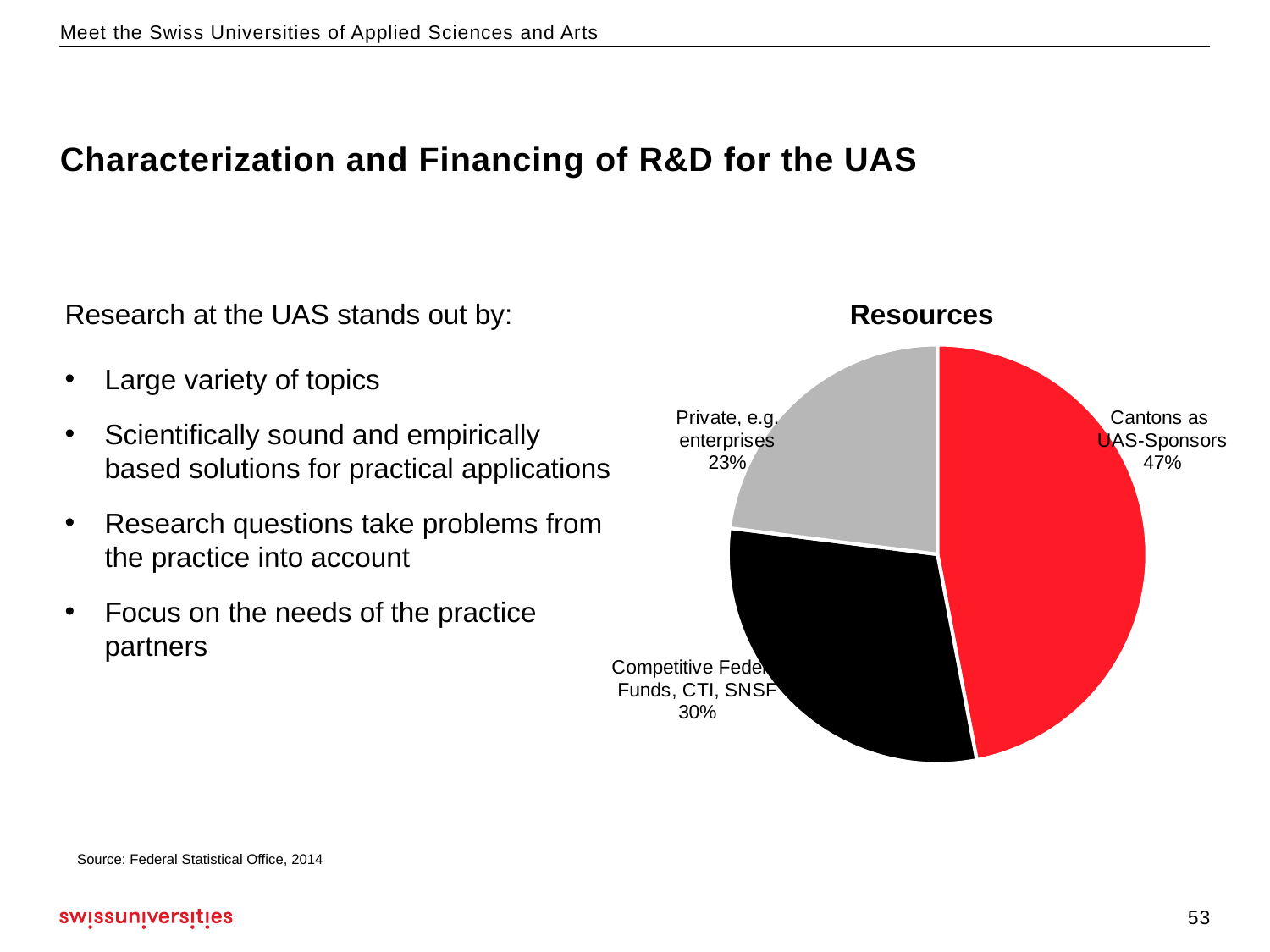
What kind of chart is used to show Resources? Pie chart What share of Resources comes from Competitive Federal Funds, CTI, SNSF? 30% Which source provides the largest share of Resources? Cantons as UAS-Sponsors How many percentage points larger is the Competitive Federal Funds, CTI, SNSF share than the Private, e.g. enterprises share? 7 How many slices does the Resources pie chart have? 3 What is the title of the chart on the slide? Resources How many percentage points larger is the Cantons as UAS-Sponsors share than the Private, e.g. enterprises share? 24 What share of Resources comes from Private, e.g. enterprises? 23% What share of Resources comes from Cantons as UAS-Sponsors? 47% Which source provides the smallest share of Resources? Private, e.g. enterprises What colour is the Cantons as UAS-Sponsors slice? Red Which is larger: the share from Competitive Federal Funds, CTI, SNSF or from Private, e.g. enterprises? Competitive Federal Funds, CTI, SNSF